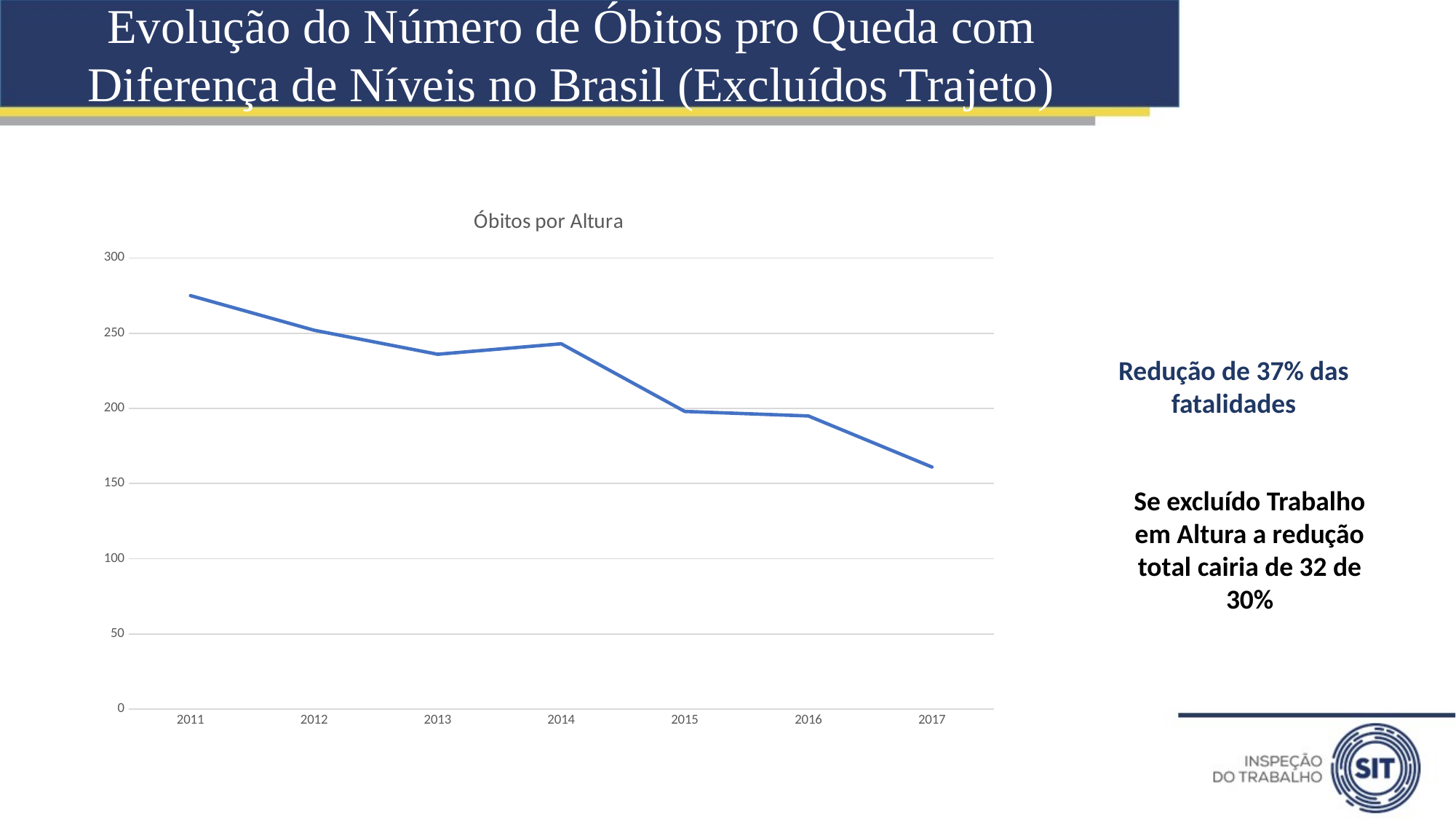
What is the title of the chart? Óbitos por Altura Which year has the lowest number of deaths in the chart? 2017 Is the value for 2013 greater or less than 250? less Which year has the highest number of deaths in the chart? 2011 Is the value for 2015 greater or less than 150? greater Do the values in the chart generally rise or fall from 2011 to 2017? fall Is the value for 2011 greater or less than 250? greater How many years are plotted on the x axis of the chart? 7 What kind of chart is shown on the slide? line chart Which year has a larger value, 2012 or 2015? 2012 Which year has a larger value, 2011 or 2017? 2011